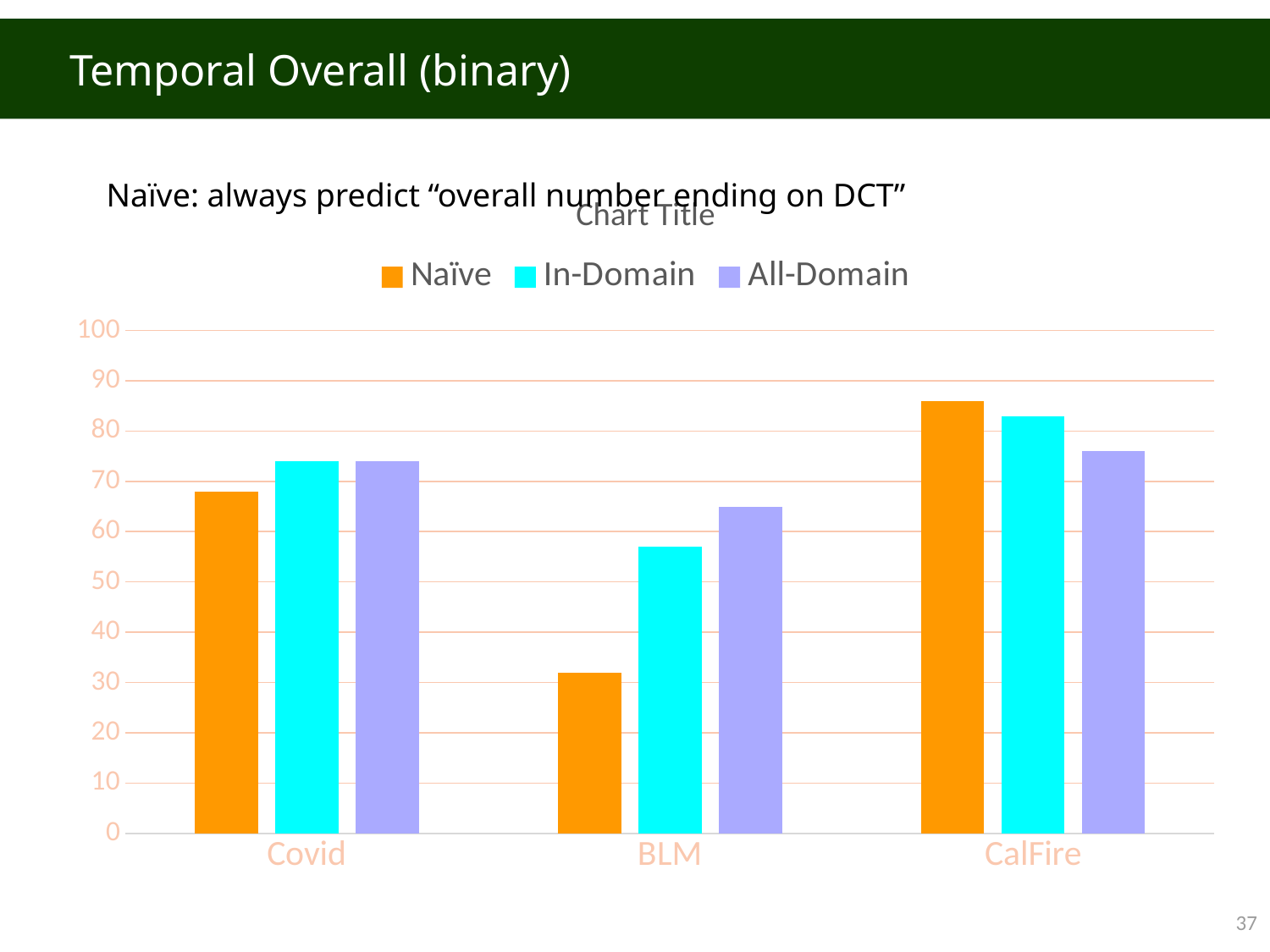
Which series is shown in orange in the legend? Naïve Which category has the highest In-Domain value? CalFire How many categories are shown on the x axis? 3 Is the Naïve value for CalFire greater or less than 80? greater Is the Naïve value for BLM greater or less than 40? less Which category has the lowest Naïve value? BLM How many series does the legend list? 3 What kind of chart is shown on the slide? bar chart Which category has the highest Naïve value? CalFire Which category has the lowest All-Domain value? BLM For BLM, which is larger, the Naïve value or the All-Domain value? All-Domain Is the In-Domain value for Covid greater or less than 70? greater